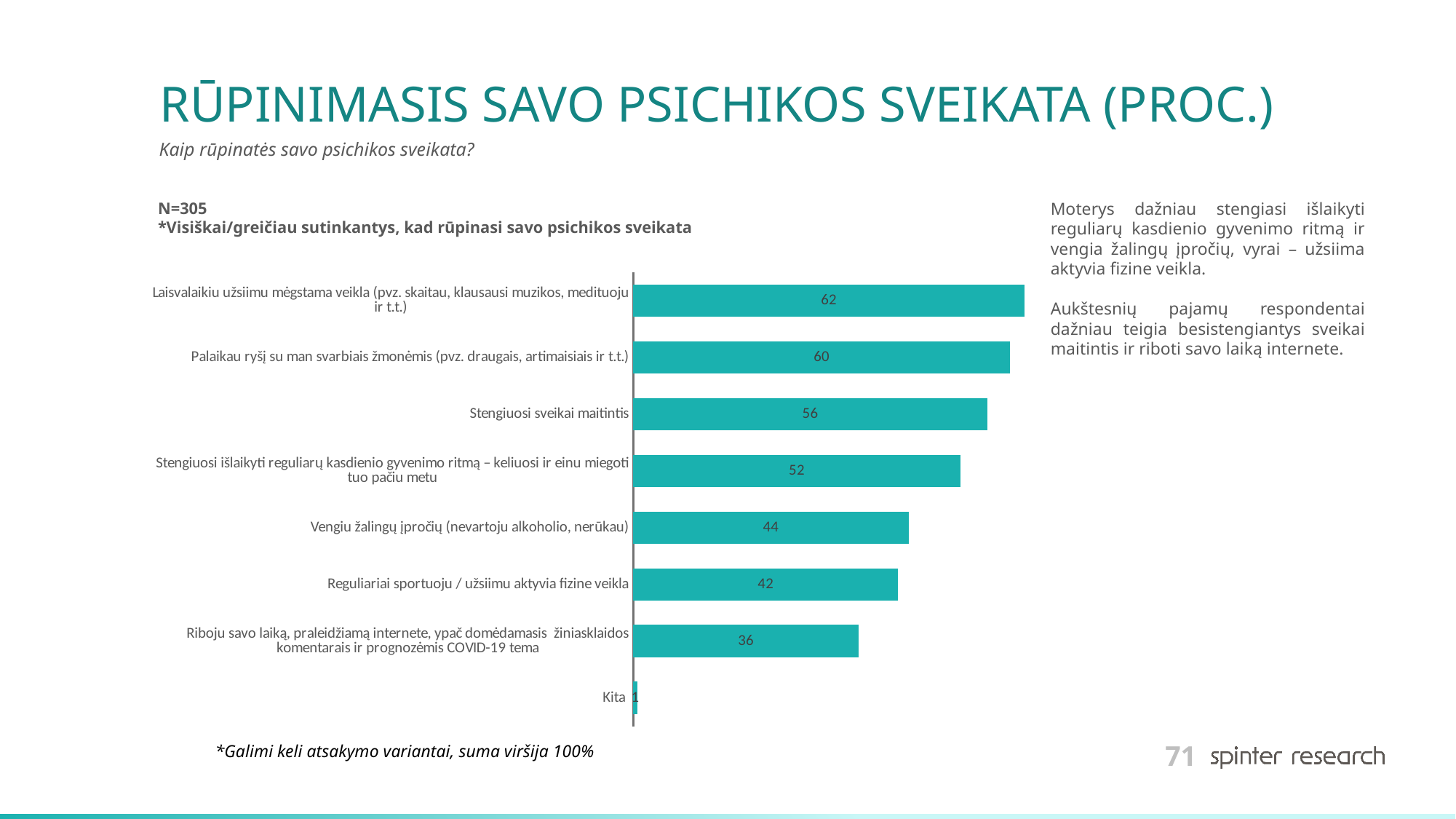
What kind of chart is shown on the slide? Bar chart How many categories are shown in the chart? 8 What is the value for "Reguliariai sportuoju / užsiimu aktyvia fizine veikla"? 42 What is the sample size (N) stated on the slide? N=305 What is the value for "Vengiu žalingų įpročių (nevartoju alkoholio, nerūkau)"? 44 What is the value for "Stengiuosi sveikai maitintis"? 56 Which category has the highest value? Laisvalaikiu užsiimu mėgstama veikla (pvz. skaitau, klausausi muzikos, medituoju ir t.t.) What is the difference between the values for "Palaikau ryšį su man svarbiais žmonėmis" and "Stengiuosi sveikai maitintis"? 4 What is the difference between the values for "Stengiuosi išlaikyti reguliarų kasdienio gyvenimo ritmą" and "Riboju savo laiką, praleidžiamą internete"? 16 Which category has the lowest value? Kita Which is larger: the value for "Vengiu žalingų įpročių" or the value for "Reguliariai sportuoju / užsiimu aktyvia fizine veikla"? Vengiu žalingų įpročių What is the value for "Kita"? 1